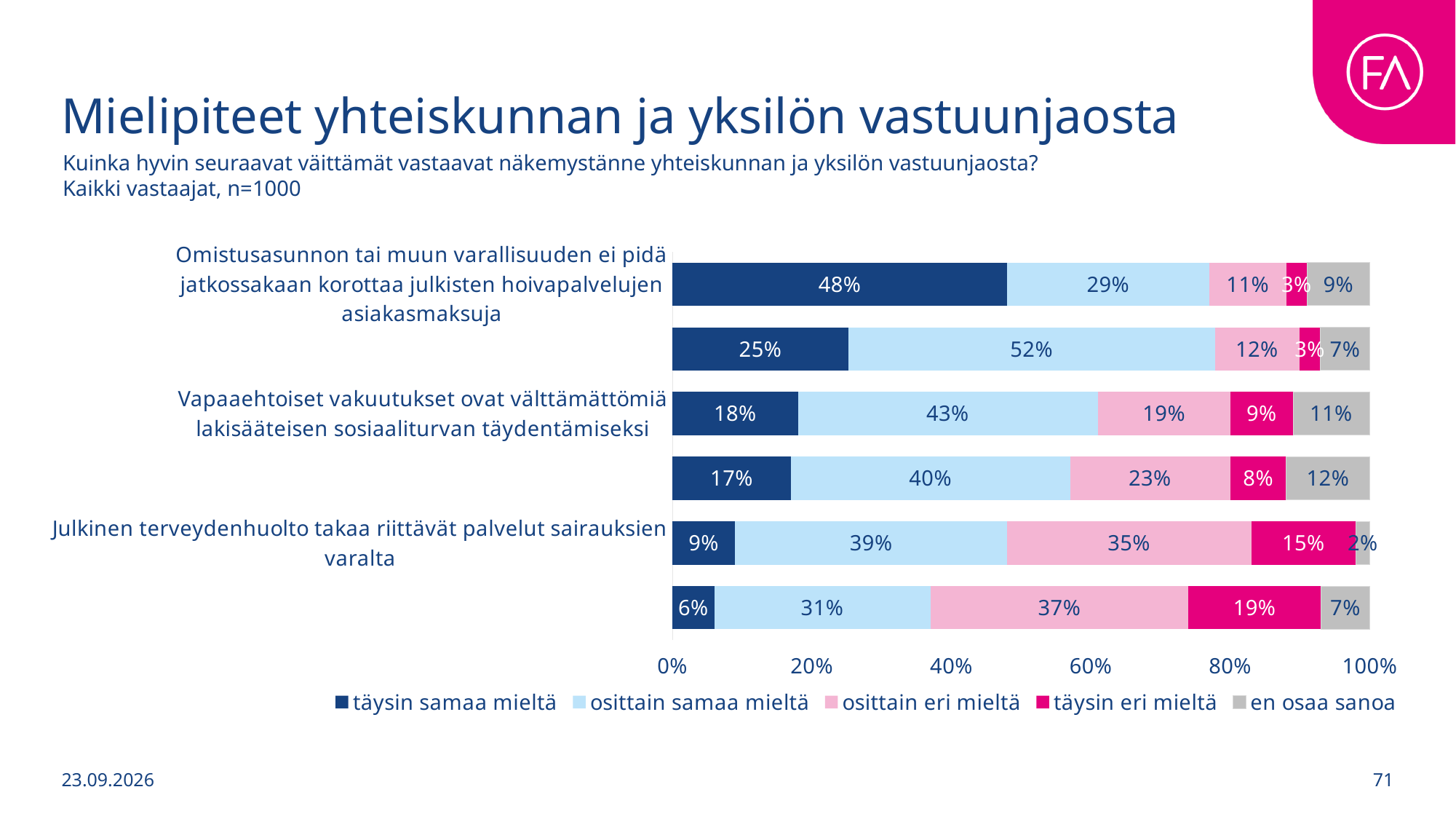
Is the 'täysin samaa mieltä' share for 'Omistusasunnon tai muun varallisuuden ei pidä...' greater or less than 40%? greater What is the combined share of 'täysin samaa mieltä' and 'osittain samaa mieltä' for 'Julkinen terveydenhuolto takaa riittävät palvelut sairauksien varalta'? 48% What is the 'osittain eri mieltä' share for the statement 'Julkinen terveydenhuolto takaa riittävät palvelut sairauksien varalta'? 35% How many series does the legend list? 5 How many bars are plotted in the chart? 6 What percentage of respondents answered 'täysin samaa mieltä' to the statement 'Omistusasunnon tai muun varallisuuden ei pidä jatkossakaan korottaa julkisten hoivapalvelujen asiakasmaksuja'? 48% What kind of chart is shown on the slide? Stacked bar chart Which has the larger 'täysin eri mieltä' share: 'Julkinen terveydenhuolto takaa riittävät palvelut sairauksien varalta' or 'Vapaaehtoiset vakuutukset ovat välttämättömiä...'? Julkinen terveydenhuolto takaa riittävät palvelut sairauksien varalta What is the 'en osaa sanoa' share for the statement 'Vapaaehtoiset vakuutukset ovat välttämättömiä lakisääteisen sosiaaliturvan täydentämiseksi'? 11% How many percentage points higher is the 'osittain samaa mieltä' share for 'Vapaaehtoiset vakuutukset ovat välttämättömiä...' than for 'Omistusasunnon tai muun varallisuuden ei pidä...'? 14 percentage points Which labelled statement has the lowest 'täysin samaa mieltä' share? Julkinen terveydenhuolto takaa riittävät palvelut sairauksien varalta Which labelled statement has the highest 'täysin samaa mieltä' share? Omistusasunnon tai muun varallisuuden ei pidä jatkossakaan korottaa julkisten hoivapalvelujen asiakasmaksuja